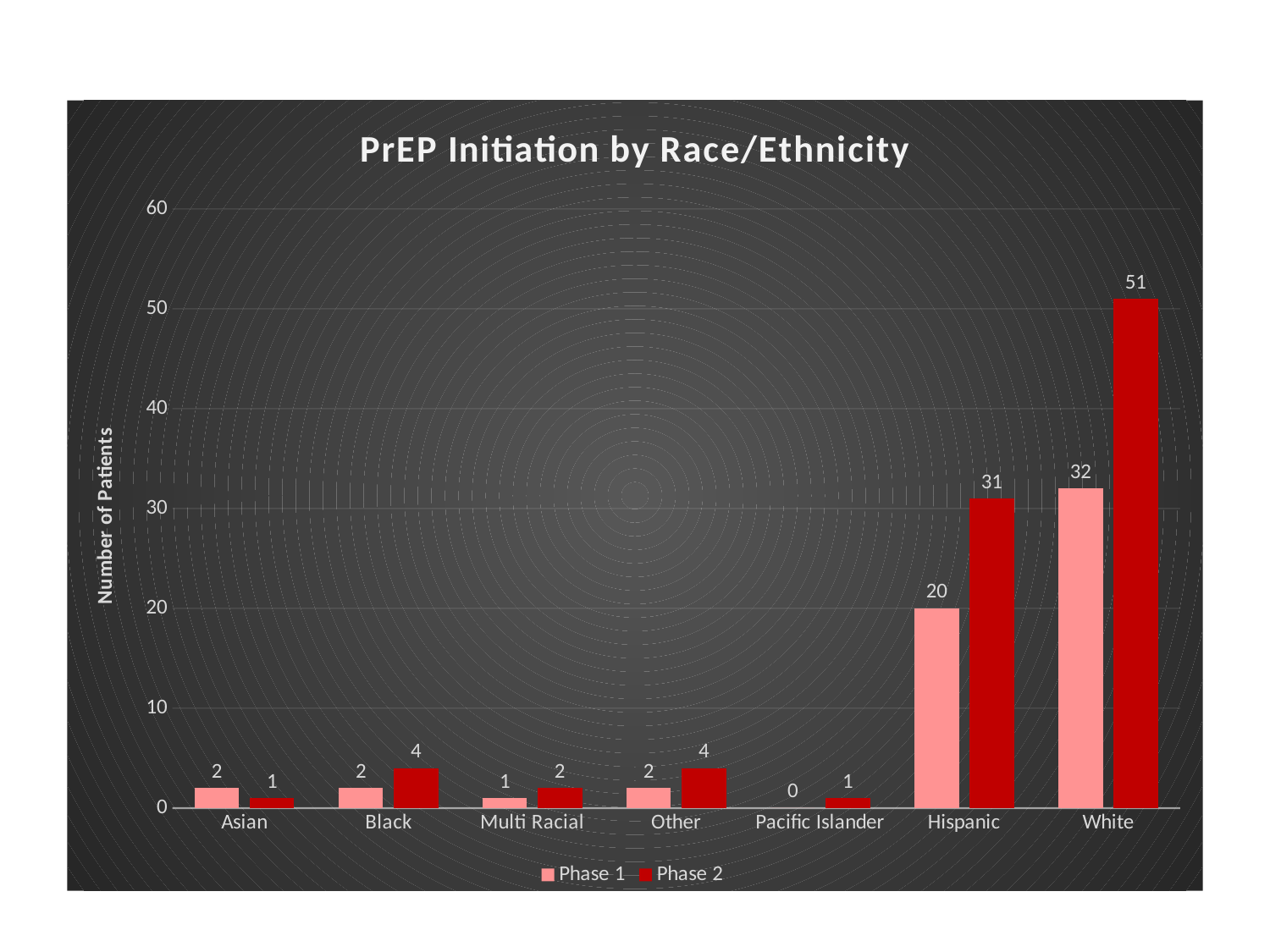
Which is larger for Black: the Phase 1 value or the Phase 2 value? Phase 2 What is the difference between the Phase 2 values for White and Hispanic? 20 What is the Phase 1 value for Pacific Islander? 0 What is the Phase 2 value for White? 51 Which category has the lowest Phase 1 value? Pacific Islander How many race/ethnicity categories are shown on the x axis? 7 How many series does the legend list? 2 What is the Phase 1 value for Hispanic? 20 Which category has the highest Phase 2 value? White What kind of chart is shown on the slide? Bar chart What is the difference between the Phase 2 and Phase 1 values for White? 19 What is the title of the chart? PrEP Initiation by Race/Ethnicity